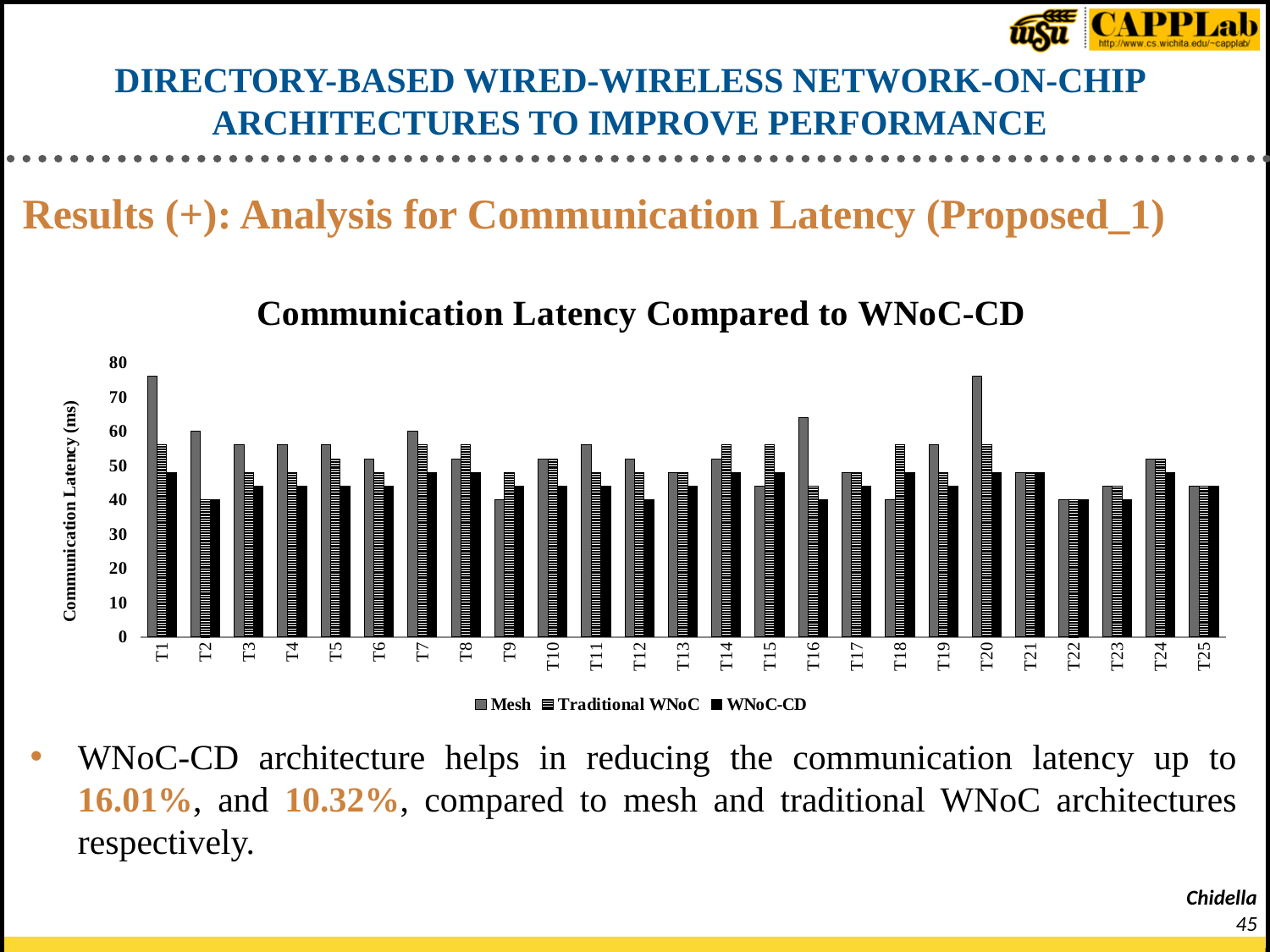
What is the label of the y axis? Communication Latency (ms) Which is larger, the Mesh value for T1 or the Mesh value for T2? T1 How many categories (T1 to T25) are plotted on the x axis? 25 Is the WNoC-CD value for T9 greater or less than 50? less Which is larger for T16, the Mesh value or the WNoC-CD value? Mesh Is the Mesh value for T20 greater or less than 70? greater Is the Mesh value for T16 greater or less than 60? greater What is the title of the chart? Communication Latency Compared to WNoC-CD How many series does the legend list? 3 What kind of chart is shown on the slide? bar chart